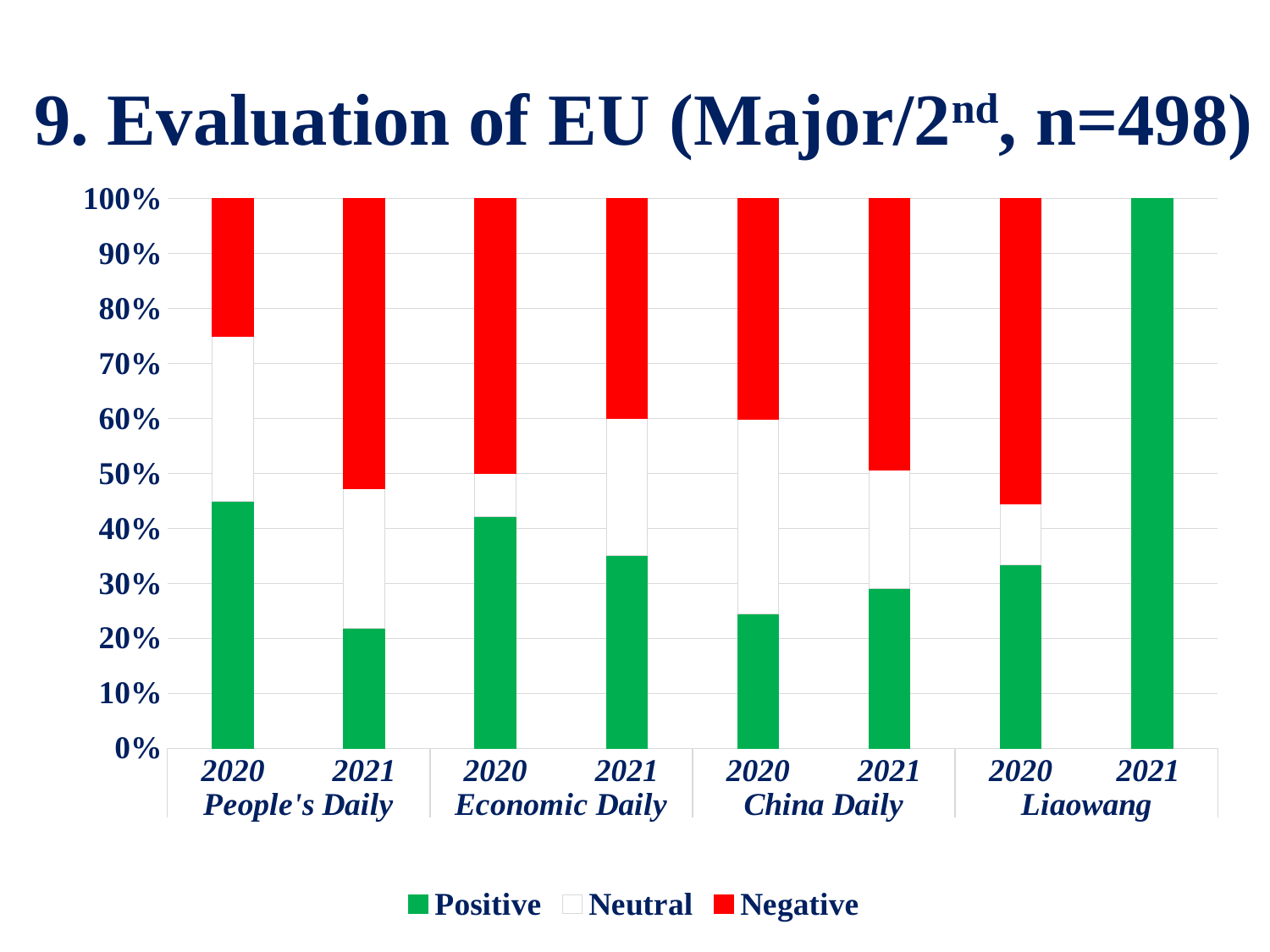
What is the Positive share for Liaowang in 2021? 100% What is the Negative share for Economic Daily in 2020? 50% Is the Positive share for People's Daily in 2021 greater or less than 30%? less How many series does the legend list? 3 Does the Positive share for Liaowang rise or fall from 2020 to 2021? Rise How many bars are plotted in the chart? 8 Which is larger, the Positive share for People's Daily in 2020 or in 2021? 2020 Is the Positive share for People's Daily in 2020 greater or less than 40%? greater Which colour represents the Negative series in the legend? Red What kind of chart is shown on the slide? Stacked bar chart Is the Positive share for China Daily in 2020 greater or less than 30%? less Which bar has the highest Positive share? Liaowang 2021